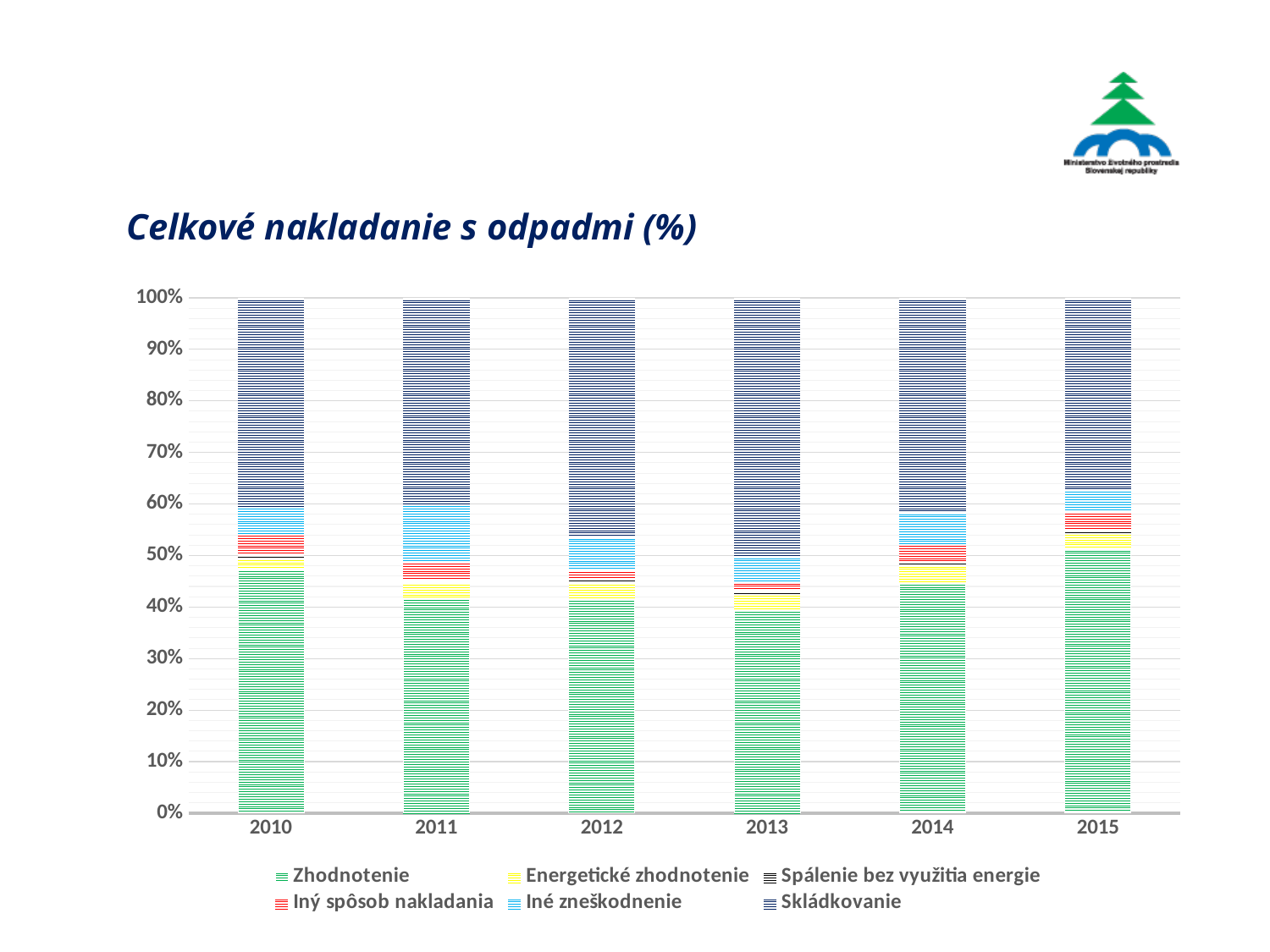
Which colour represents Zhodnotenie in the legend? green What is the title of the chart? Celkové nakladanie s odpadmi (%) What kind of chart is shown on the slide? stacked bar chart How many series does the legend list? 6 Is the value for Zhodnotenie in 2010 greater or less than 40%? greater Is the value for Zhodnotenie in 2013 greater or less than 50%? less Is the value for Energetické zhodnotenie in 2015 greater or less than 10%? less How many years are shown on the x axis of the chart? 6 What is the total of the stacked bar for 2010? 100% Which is larger: the Zhodnotenie share in 2010 or in 2013? 2010